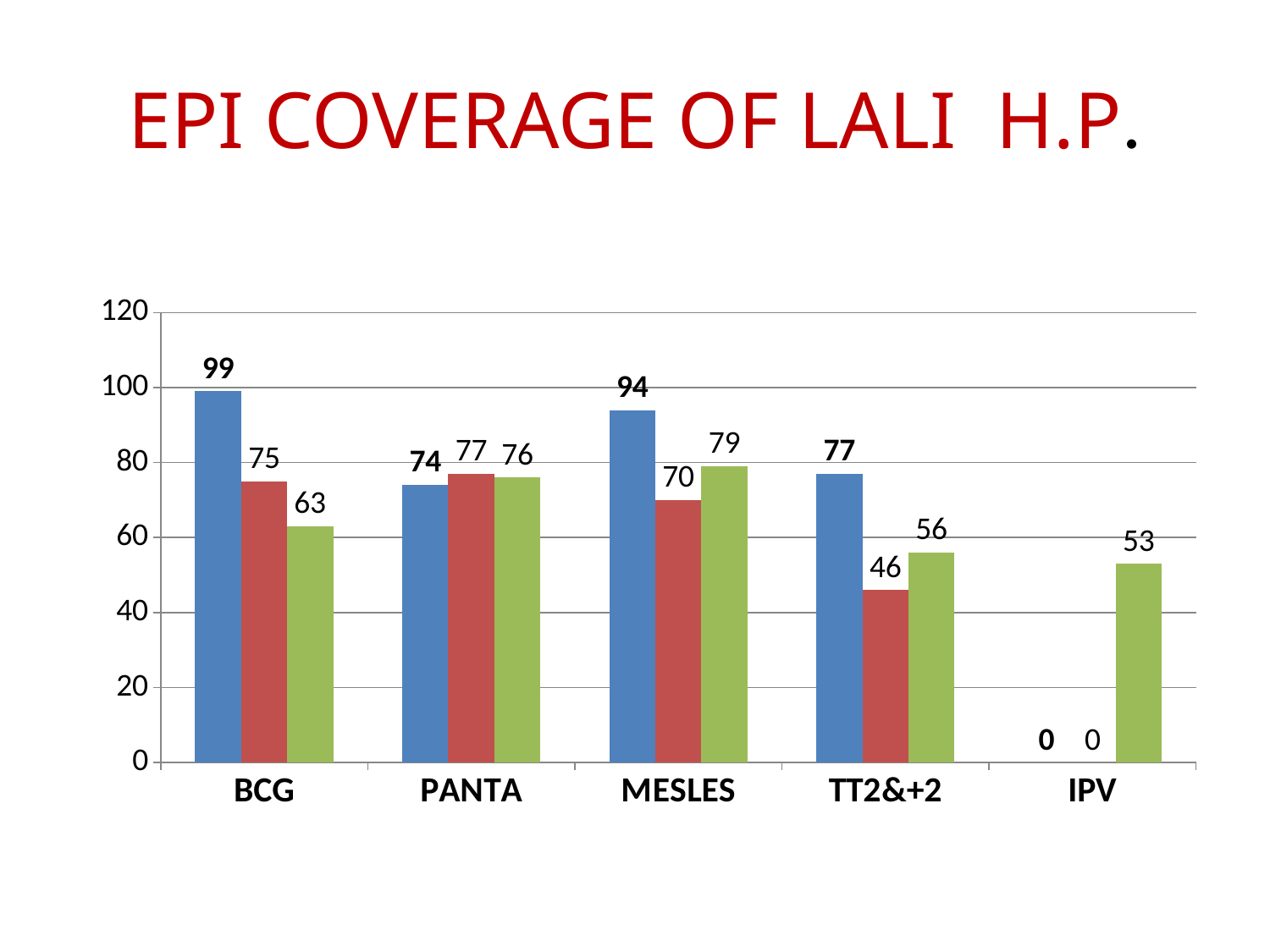
What is the value of the green bar for MESLES? 79 Which category has the lowest green bar? IPV What is the title of the slide? EPI COVERAGE OF LALI H.P. How many categories are shown on the x axis? 5 What kind of chart is shown on the slide? bar chart Which category has the highest blue bar? BCG What is the value of the blue bar for IPV? 0 What is the value of the green bar for IPV? 53 What is the value of the blue bar for BCG? 99 What is the difference between the blue bar and the green bar for BCG? 36 What is the value of the red bar for TT2&+2? 46 Which is larger for MESLES, the red bar or the green bar? the green bar